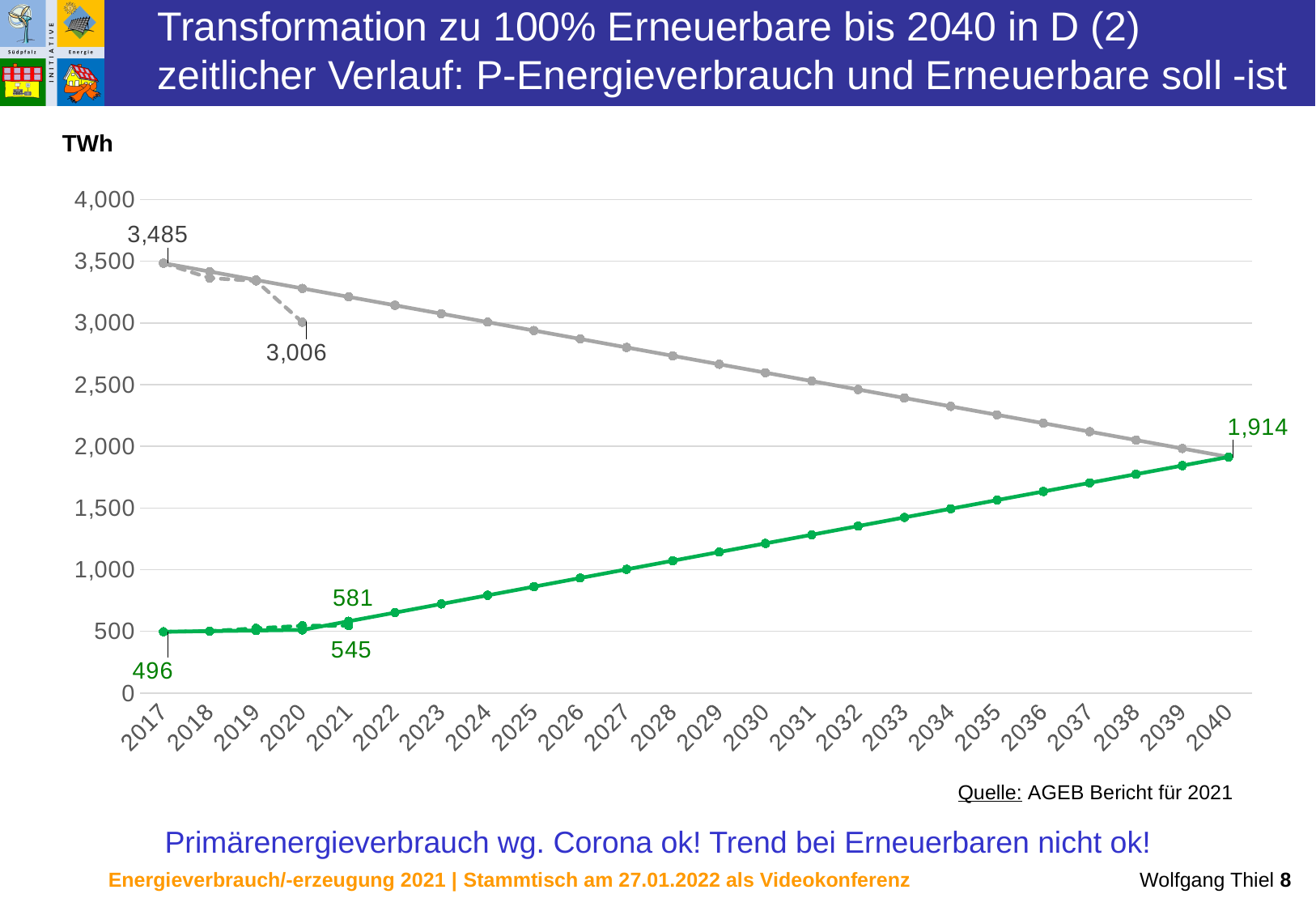
What unit is shown on the y axis of the chart? TWh What is the value of the green line (Erneuerbare) in 2017? 496 What is the actual (ist) value labelled on the dashed green line for 2021? 545 What is the value of the grey line (Primärenergieverbrauch) in 2017? 3,485 What value do the grey and green lines reach in 2040? 1,914 Does the grey line rise or fall from 2017 to 2040? fall What is the difference between the 2021 target value 581 and the actual value 545 on the green line? 36 What kind of chart is shown on the slide? line chart By how much does the grey line fall from 2017 (3,485) to 2040 (1,914)? 1,571 What value is labelled on the dashed grey line in 2020? 3,006 What is the target (soll) value labelled on the green line for 2021? 581 Is the value of the grey line in 2035 greater or less than 2,000? greater